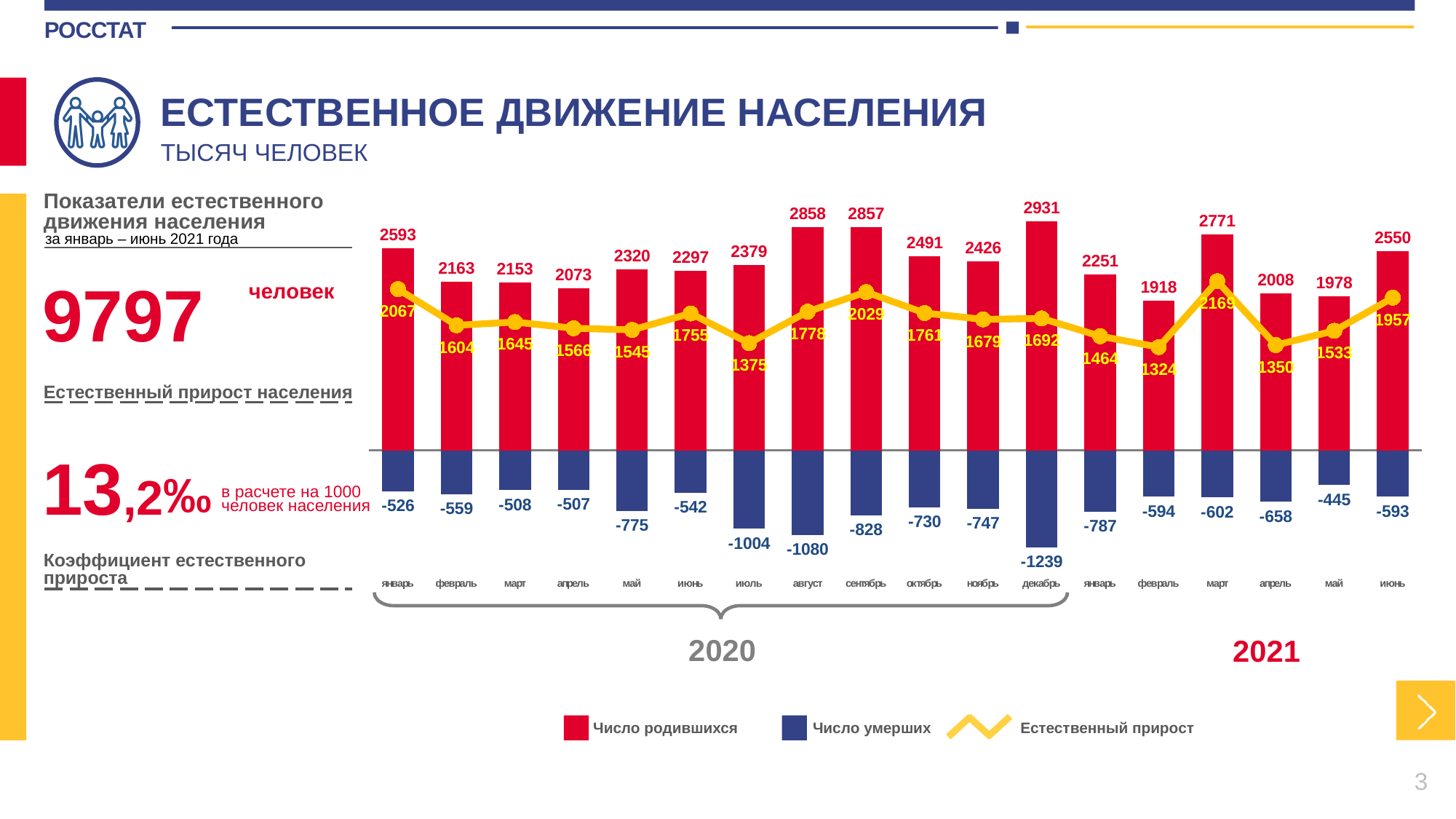
In which month is the natural increase (Естественный прирост) the lowest? февраль 2021 In which month is the number of deaths (Число умерших) the smallest in magnitude? май 2021 What kind of chart is shown on the slide? Combined bar and line chart Which is larger: the number of births in March 2021 or in April 2021? март 2021 What is the difference between the number of births in December 2020 (2931) and January 2020 (2593)? 338 In which month is the number of births (Число родившихся) the highest? декабрь 2020 In which month is the number of births (Число родившихся) the lowest? февраль 2021 What is the number of births (Число родившихся) shown for December 2020 (декабрь)? 2931 How many series does the chart legend list? 3 What is the number of deaths (Число умерших) shown for July 2020 (июль)? -1004 What value does the natural increase line (Естественный прирост) show for March 2021 (март)? 2169 How many months are plotted on the x axis of the chart? 18